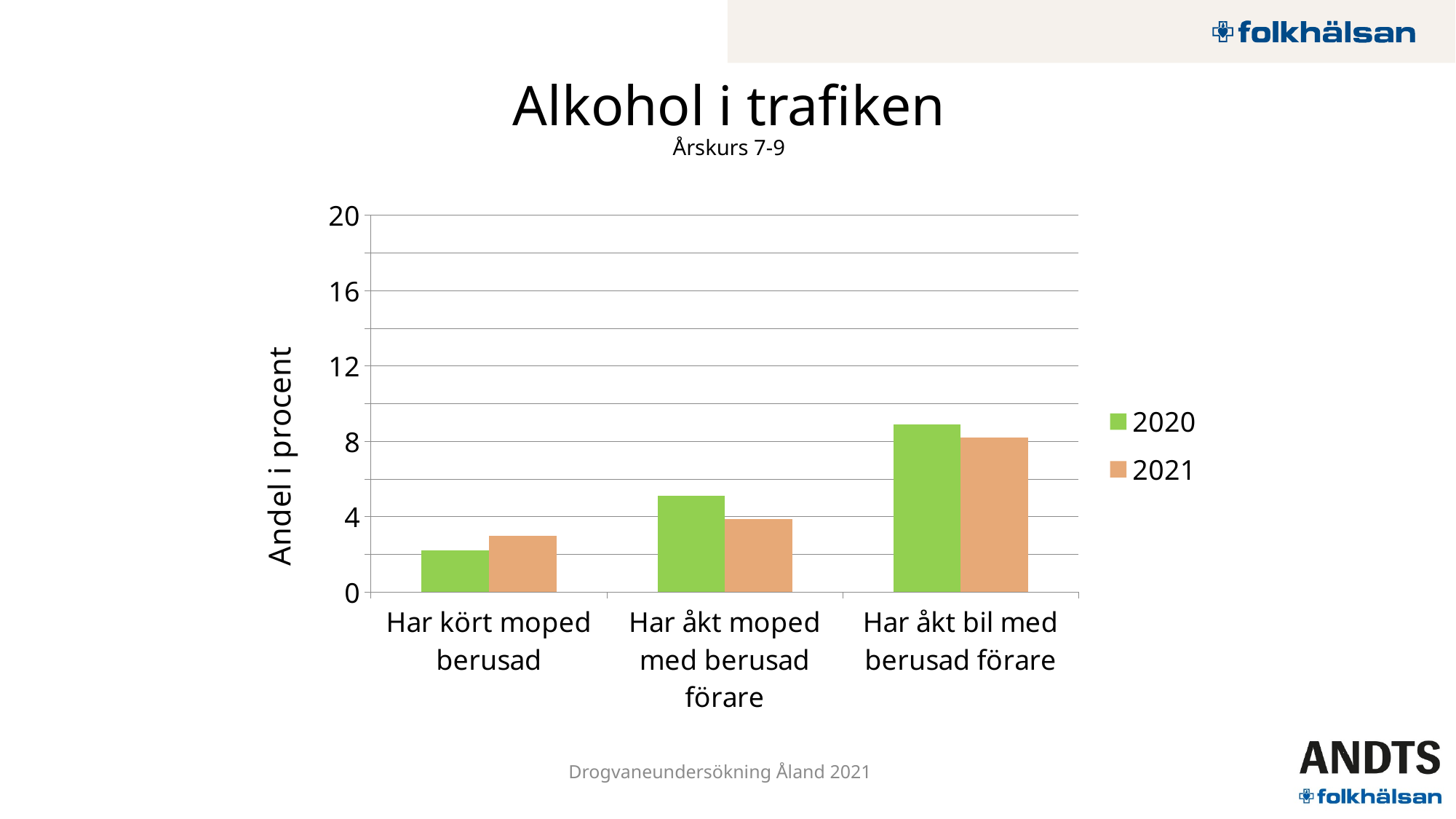
How many categories are shown on the x axis of the chart? 3 Is the 2020 value for 'Har åkt moped med berusad förare' greater or less than 4? greater For 'Har åkt moped med berusad förare', which series has the larger value, 2020 or 2021? 2020 What is the label on the vertical axis of the chart? Andel i procent Is the 2020 value for 'Har åkt bil med berusad förare' greater or less than 8? greater For 'Har kört moped berusad', which series has the larger value, 2020 or 2021? 2021 What kind of chart is shown on the slide? Bar chart Do the 2020 values rise or fall from left to right across the categories? Rise Which category has the lowest value for the 2021 series? Har kört moped berusad Which category has the highest value for the 2020 series? Har åkt bil med berusad förare How many series does the legend list? 2 Is the 2021 value for 'Har kört moped berusad' greater or less than 4? less